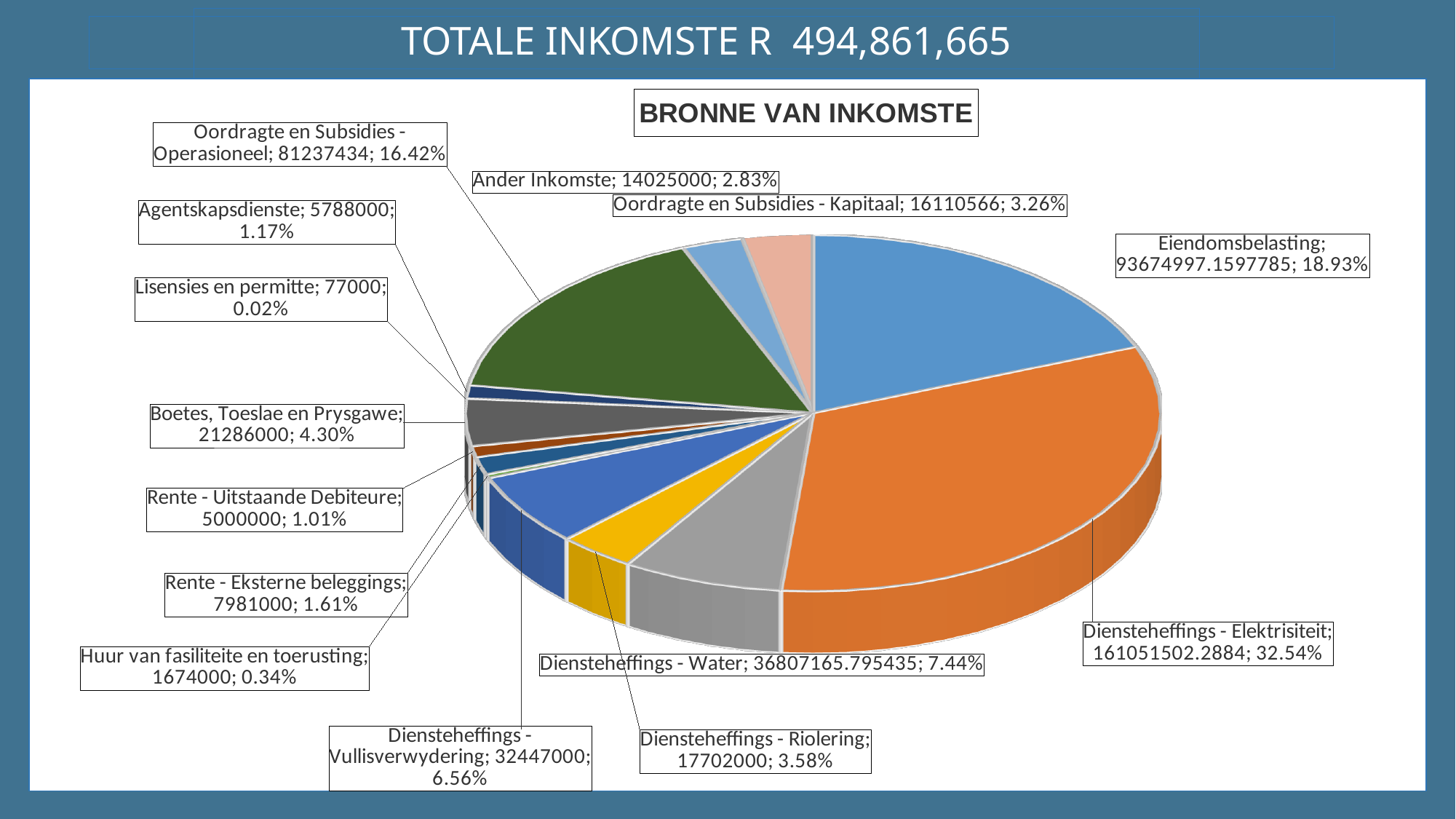
Which is larger, Diensteheffings - Water or Diensteheffings - Vullisverwydering? Diensteheffings - Water Which category has the largest slice of the pie? Diensteheffings - Elektrisiteit How many categories (slices) does the pie chart have? 14 What is the value shown for Rente - Eksterne beleggings? 7981000 What is the value shown for Boetes, Toeslae en Prysgawe? 21286000 What is the title of the chart? BRONNE VAN INKOMSTE What is the difference between the values for Diensteheffings - Vullisverwydering and Diensteheffings - Riolering? 14745000 What is the value shown for Oordragte en Subsidies - Operasioneel? 81237434 Which category has the smallest slice of the pie? Lisensies en permitte What share of the pie does Diensteheffings - Elektrisiteit represent? 32.54% What kind of chart is shown on the slide? pie chart What percentage is shown for Lisensies en permitte? 0.02%